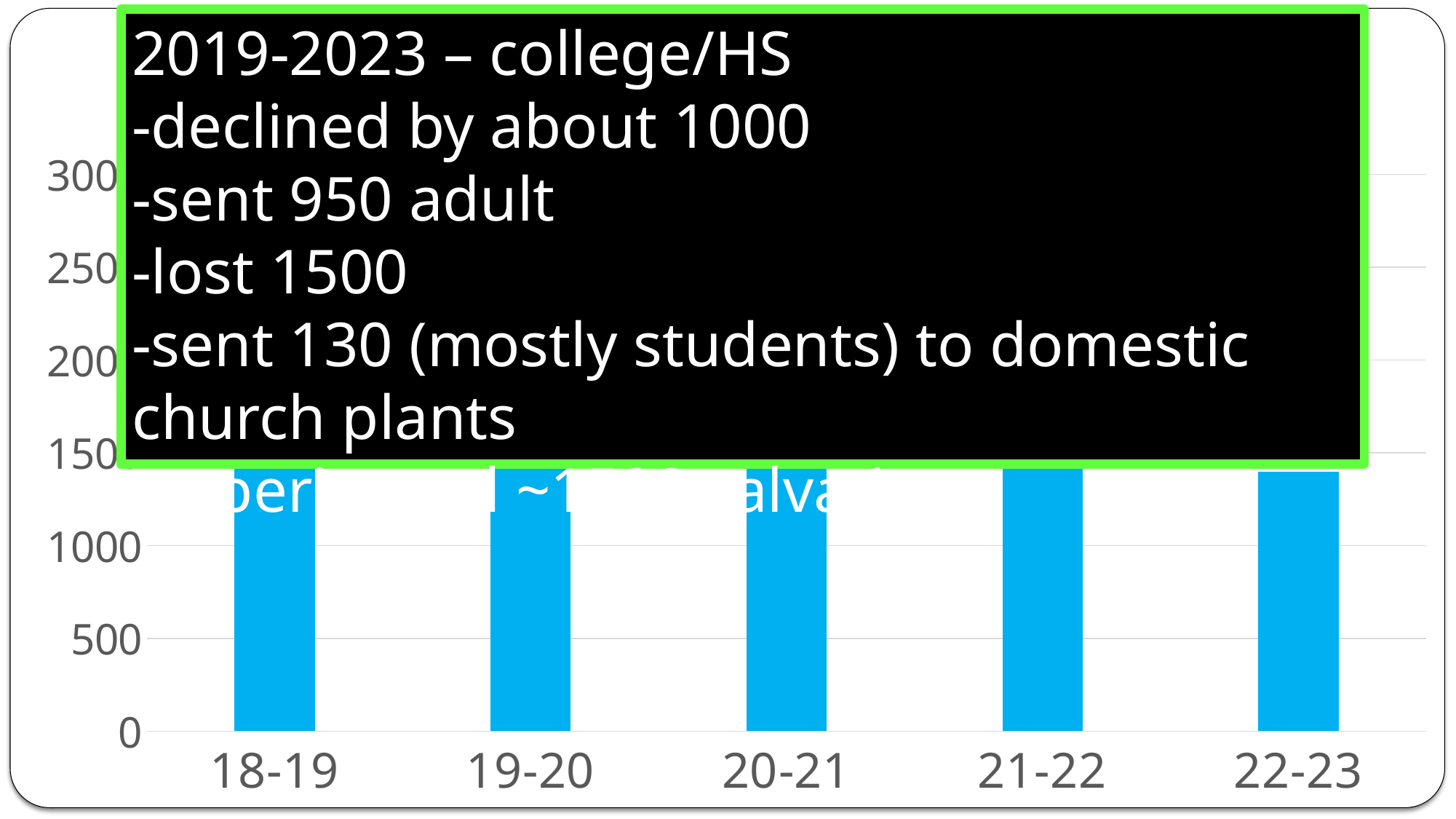
Is the value for 20-21 greater or less than 500? greater Is the value for 19-20 greater or less than 1000? greater What is the highest tick value shown on the y axis of the chart? 3000 What kind of chart is shown on the slide? bar chart Is the value for 21-22 greater or less than 1000? greater How many categories are shown on the x axis of the chart? 5 What is the first category label on the x axis of the chart? 18-19